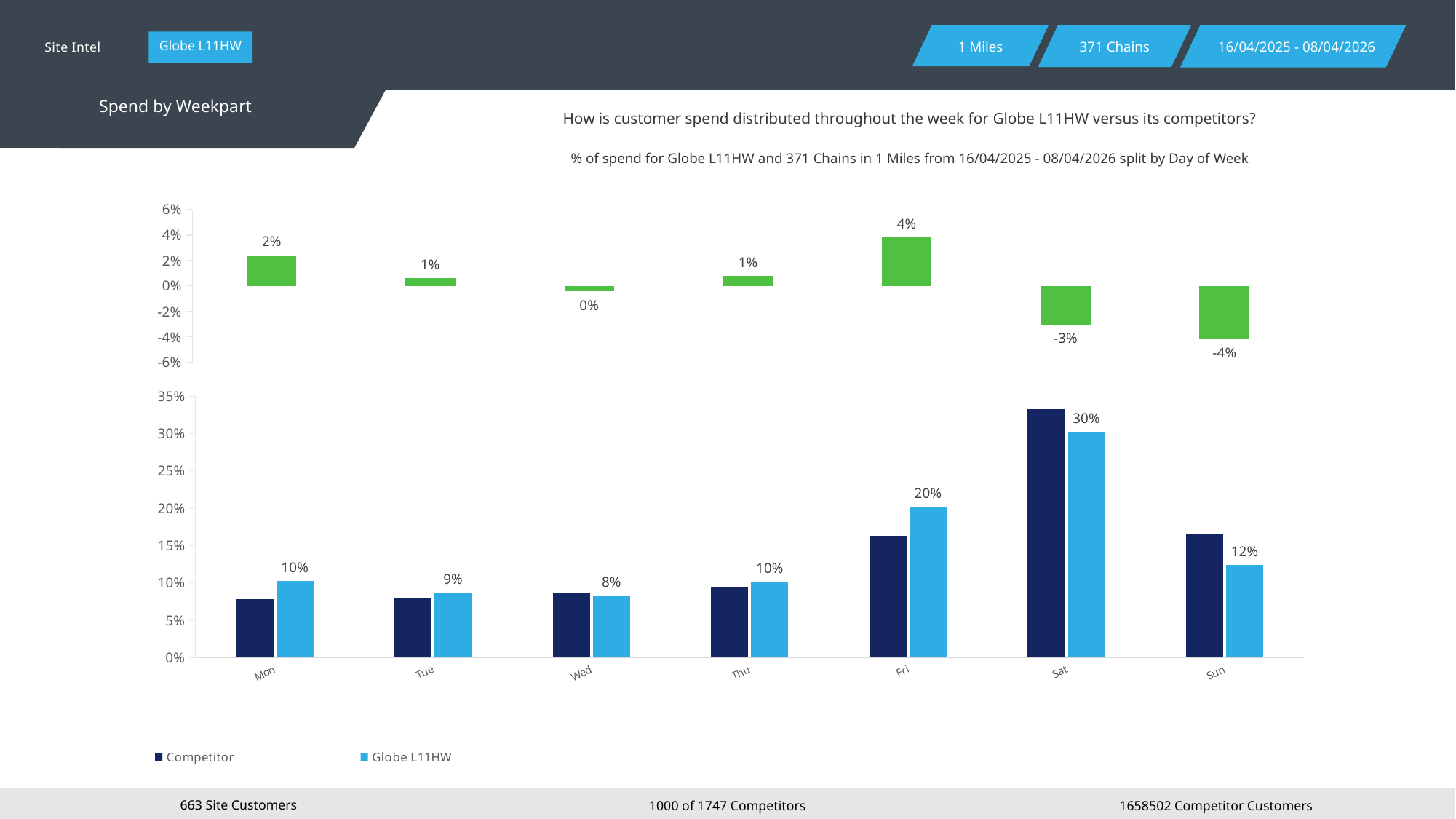
How many series does the legend of the bottom chart list? 2 What kind of chart is the bottom chart? bar chart In the bottom chart, which day has the highest Globe L11HW value? Sat In the bottom chart, what is the difference between the Globe L11HW values for Fri and Sun? 8% How many days of the week are shown on the x axis of the bottom chart? 7 In the bottom chart, is the Competitor value for Fri greater or less than 15%? greater In the top chart, what is the value for Fri? 4% In the bottom chart, which day has the lowest Globe L11HW value? Wed In the bottom chart, what is the value for Globe L11HW on Sat? 30% In the bottom chart, do the Globe L11HW values rise or fall from Thu to Sat? rise In the bottom chart, on Sat, which is larger: the Competitor bar or the Globe L11HW bar? Competitor In the top chart, which day has the lowest value? Sun